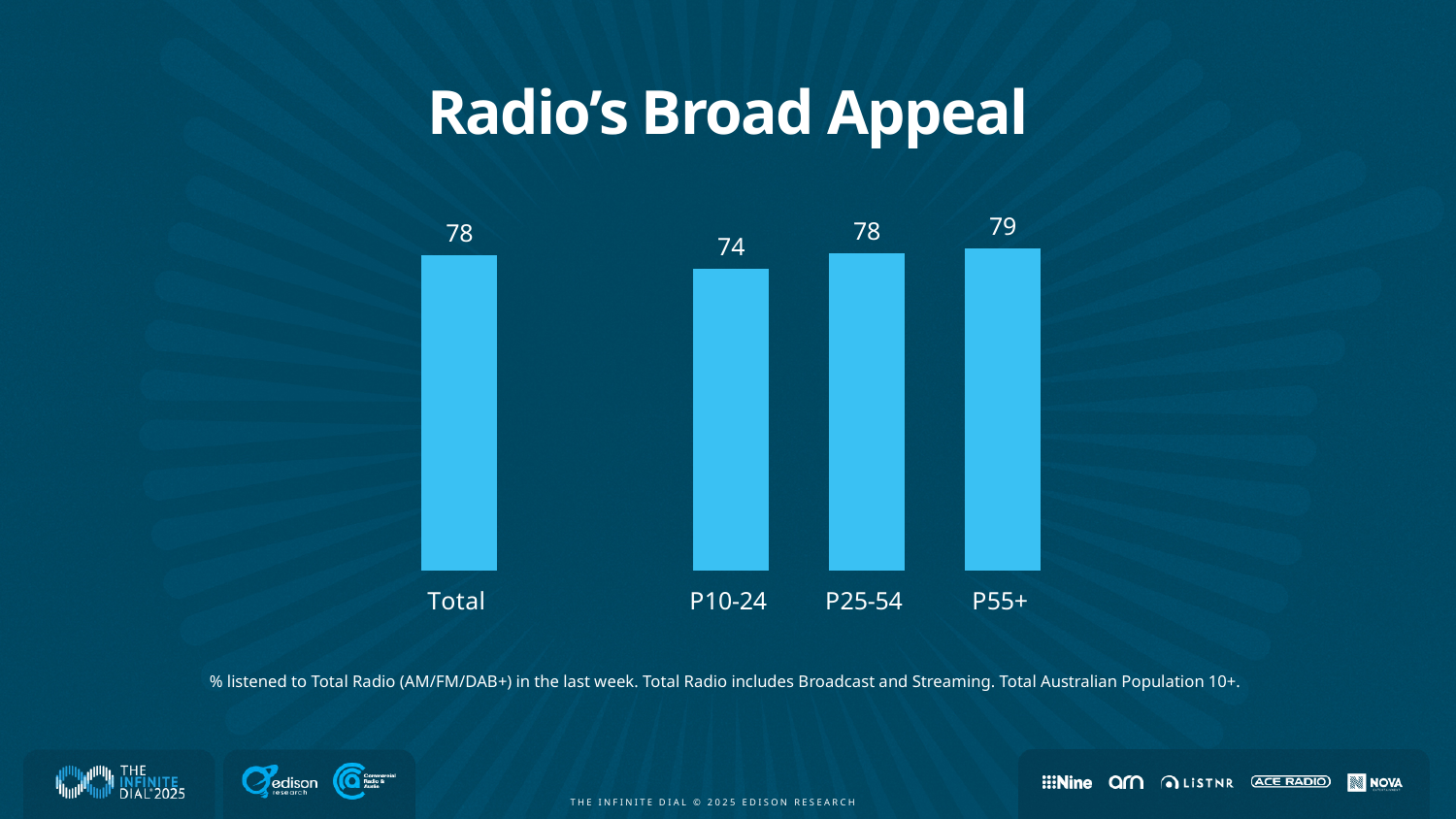
What is the value for P25-54? 78 What is the value for P10-24? 74 What is the difference between the values for Total and P10-24? 4 How many categories are shown in the chart? 4 What is the title of the slide? Radio's Broad Appeal Which is larger, the value for P25-54 or the value for P10-24? P25-54 What kind of chart is shown on the slide? Bar chart Which category has the highest value? P55+ What is the value for Total? 78 Which category has the lowest value? P10-24 What is the difference between the values for P55+ and P10-24? 5 What is the value for P55+? 79